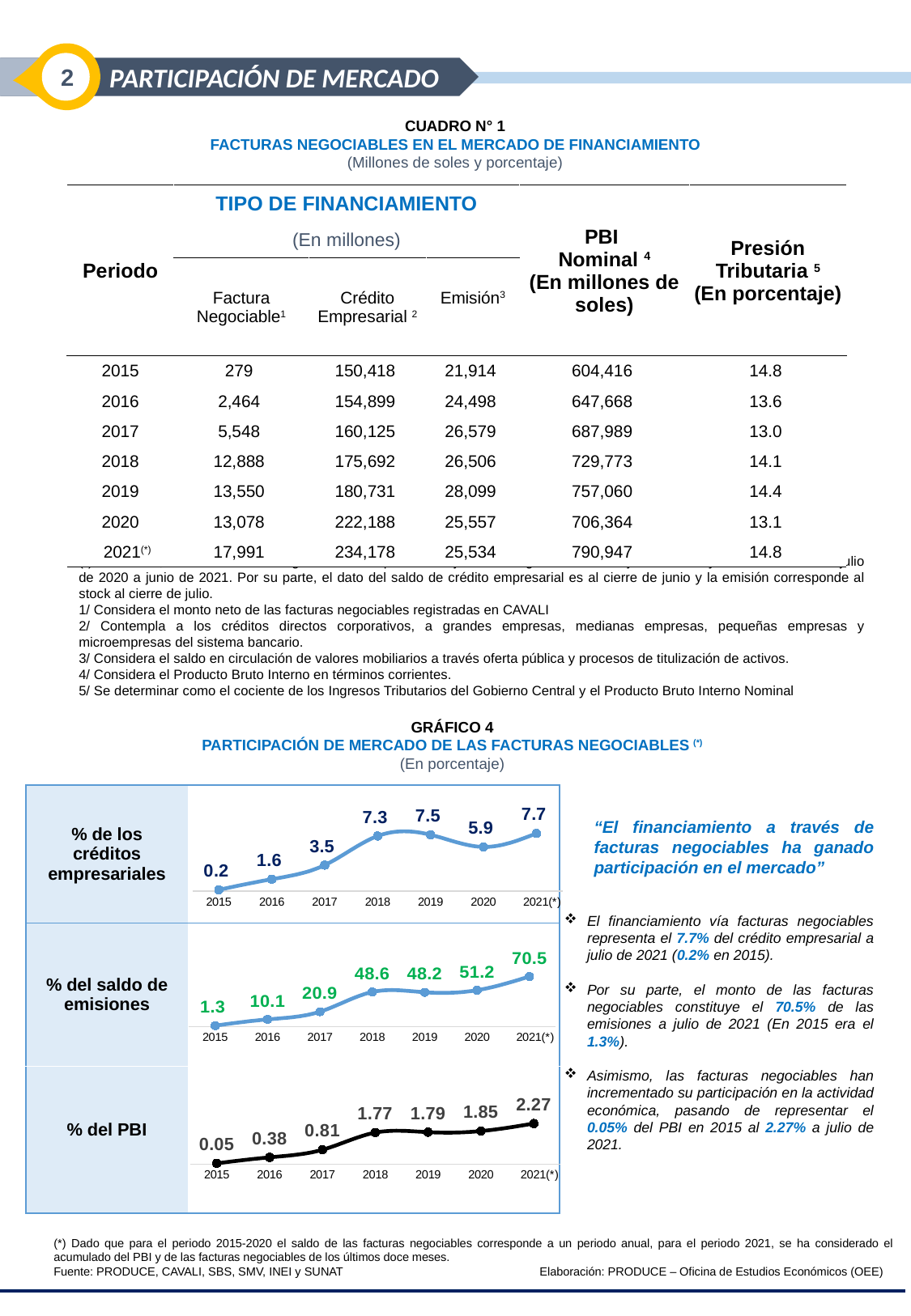
In the '% de los créditos empresariales' chart, what is the value for 2018? 7.3 In the '% del PBI' chart, what is the value for 2017? 0.81 In the '% del PBI' chart, do the values generally rise or fall from 2015 to 2021(*)? Rise In the '% de los créditos empresariales' chart, which year has the highest value? 2021(*) What type of chart is used in Gráfico 4 for '% del PBI'? Line chart In the '% del PBI' chart, what is the difference between the 2021(*) value and the 2015 value? 2.22 In the '% de los créditos empresariales' chart, which is larger, the value for 2019 or the value for 2020? 2019 How many data points are plotted in the '% del saldo de emisiones' chart? 7 In the '% del saldo de emisiones' chart, which year has the lowest value? 2015 In the '% del saldo de emisiones' chart, what is the difference between the 2018 value and the 2017 value? 27.7 In the '% del saldo de emisiones' chart, what is the value for 2020? 51.2 What is the title of Gráfico 4? PARTICIPACIÓN DE MERCADO DE LAS FACTURAS NEGOCIABLES